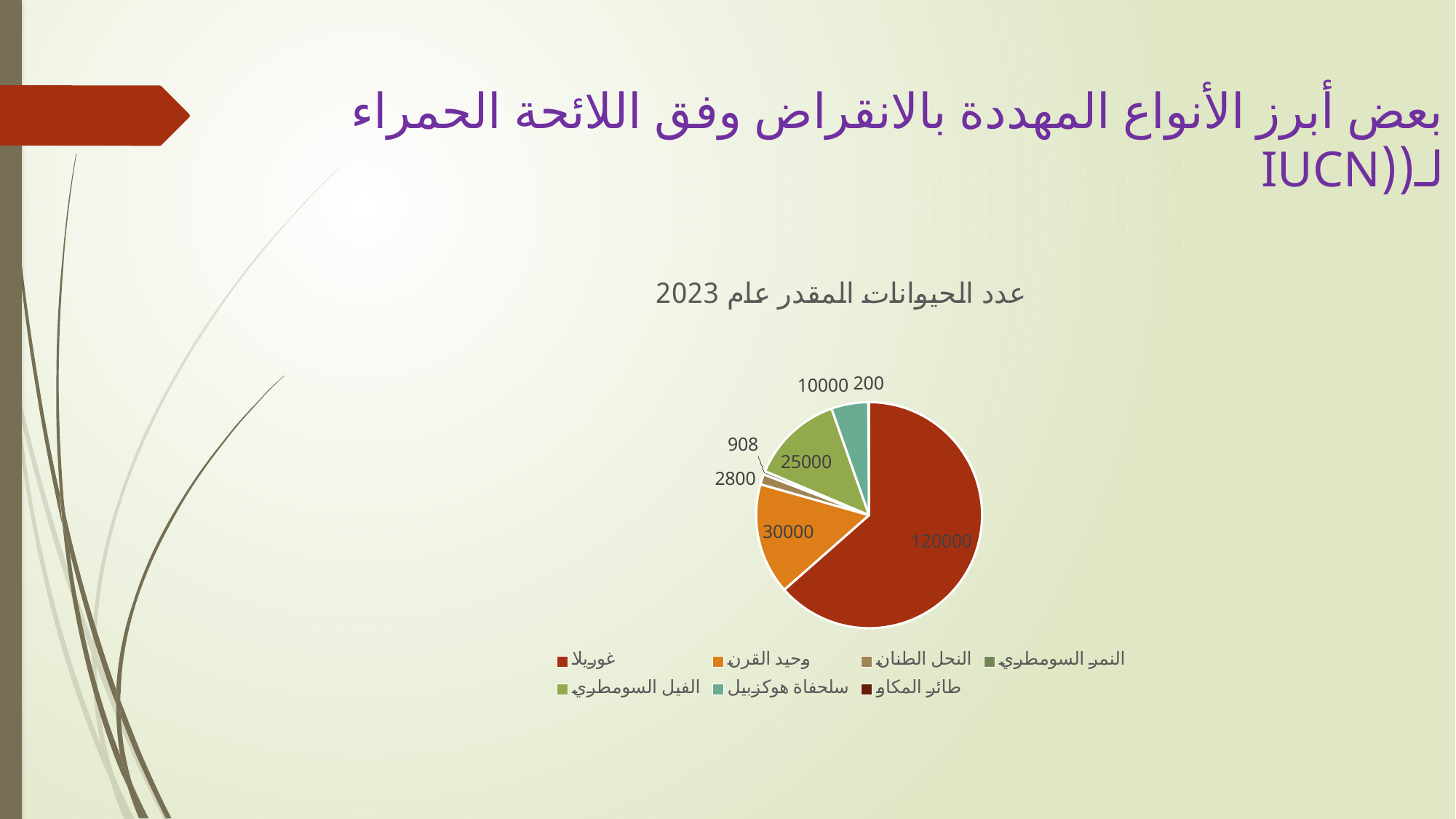
What is the title of the chart? عدد الحيوانات المقدر عام 2023 What is the value for النمر السومطري (Sumatran tiger) in the pie chart? 908 Which category has the largest slice in the pie chart? غوريلا What is the difference between the values for وحيد القرن and الفيل السومطري? 5000 What type of chart is shown on the slide? Pie chart What is the value for غوريلا (gorilla) in the pie chart? 120000 What is the value for الفيل السومطري (Sumatran elephant) in the pie chart? 25000 How many categories does the legend of the pie chart list? 7 What is the value for وحيد القرن (rhinoceros) in the pie chart? 30000 What is the value for سلحفاة هوكزبيل (hawksbill turtle) in the pie chart? 10000 Which category has the smallest slice in the pie chart? طائر المكاو Which is larger, the value for النحل الطنان or the value for النمر السومطري? النحل الطنان